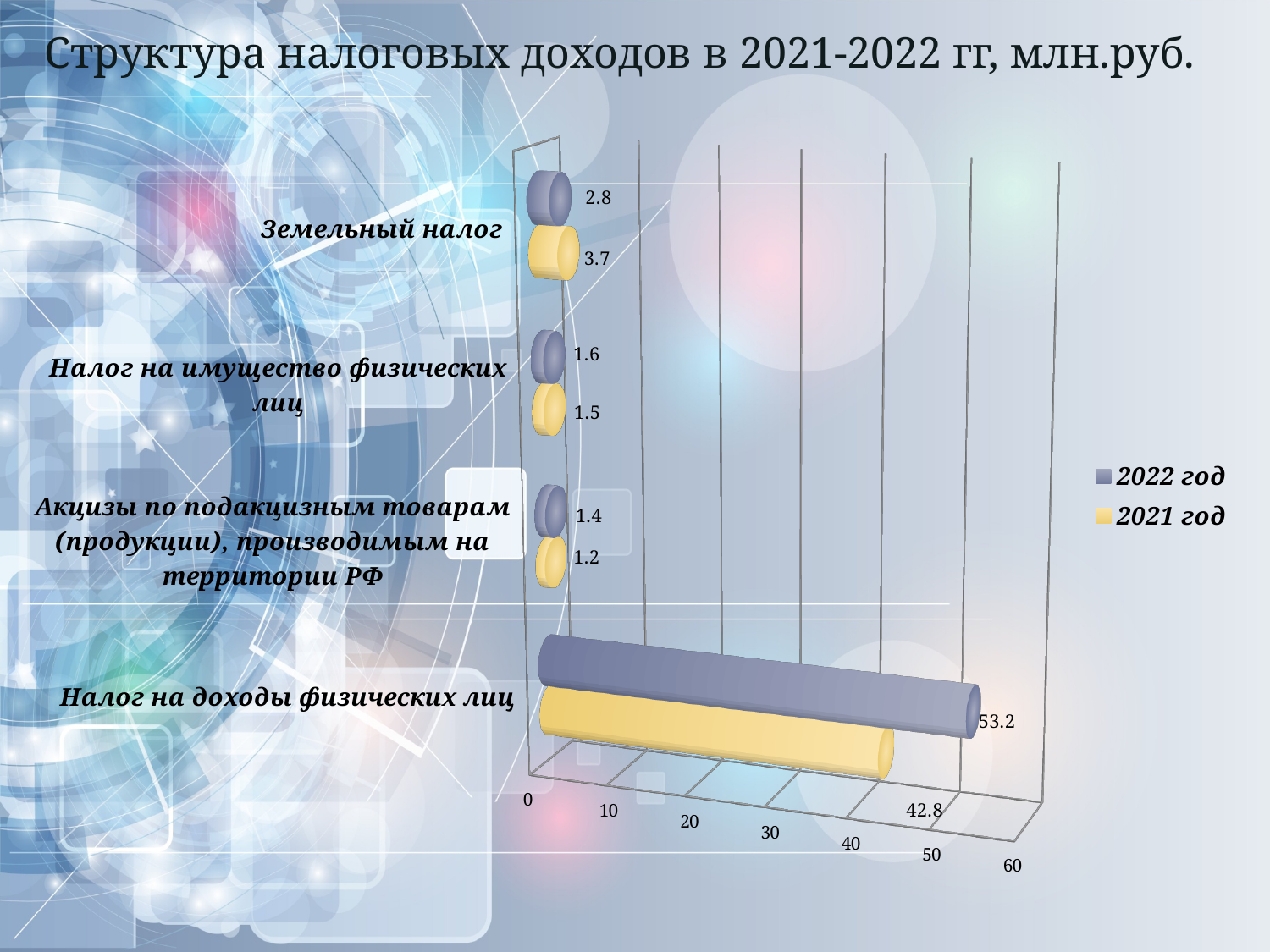
For Земельный налог, which series has the larger value, 2022 год or 2021 год? 2021 год What kind of chart is shown on the slide? Bar chart Which category has the lowest value in the 2021 год series? Акцизы по подакцизным товарам (продукции), производимым на территории РФ Which category has the highest value in the 2022 год series? Налог на доходы физических лиц What is the value for Налог на доходы физических лиц in the 2021 год series? 42.8 How many series does the legend list? 2 What is the difference between the 2022 год and 2021 год values for Налог на доходы физических лиц? 10.4 What is the value for Акцизы по подакцизным товарам (продукции), производимым на территории РФ in the 2021 год series? 1.2 How many categories are shown on the chart? 4 What is the value for Земельный налог in the 2021 год series? 3.7 What is the value for Налог на доходы физических лиц in the 2022 год series? 53.2 What is the value for Земельный налог in the 2022 год series? 2.8